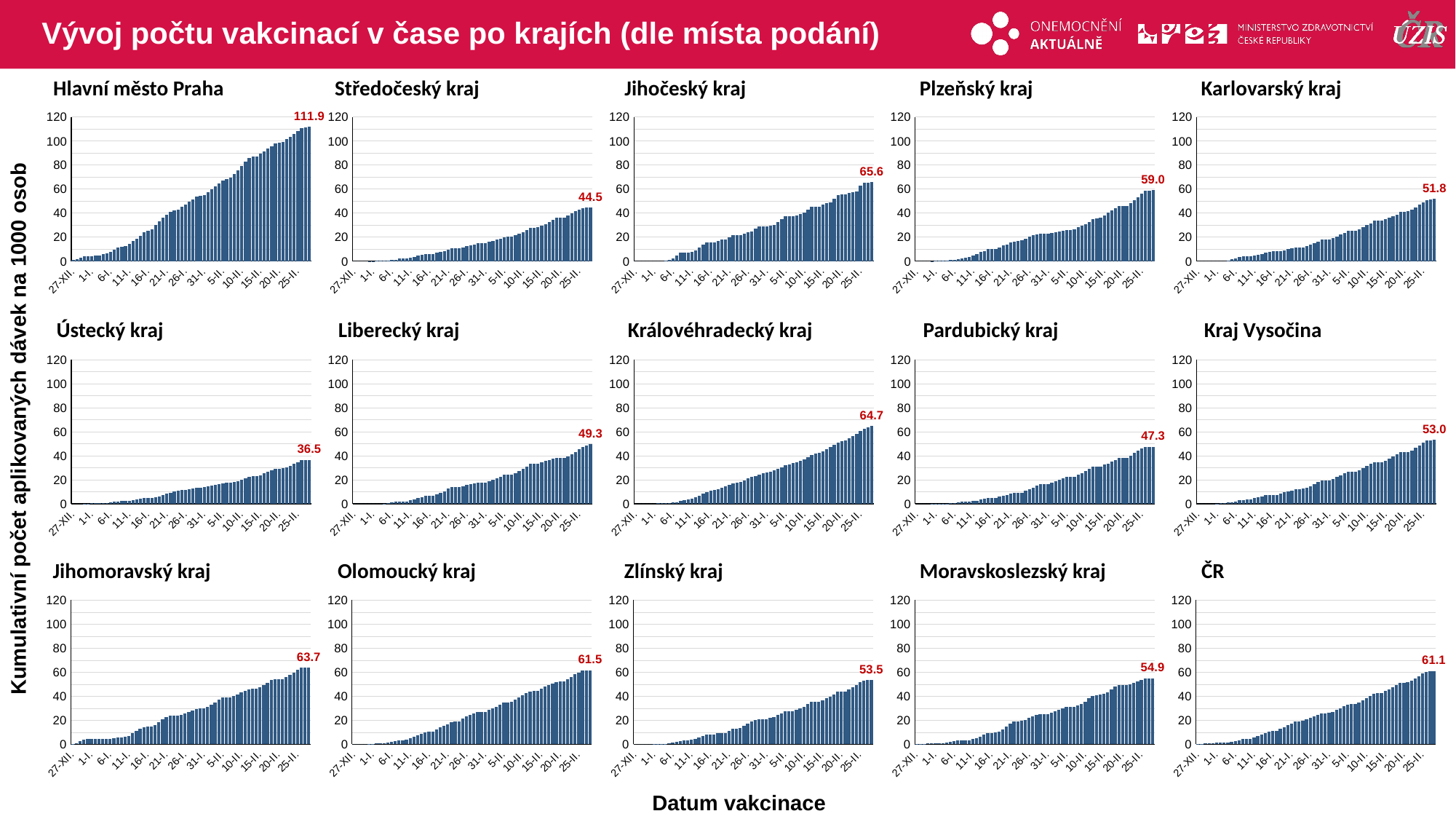
How many separate charts are shown on the slide? 15 In the ČR chart, what is the final labelled value? 61.1 Comparing the final labelled values across all the charts, which region has the lowest value? Ústecký kraj What kind of chart is used for each region on the slide? Bar chart In the Ústecký kraj chart, what is the final labelled value? 36.5 What is the difference between the final labelled value in the Jihočeský kraj chart (65.6) and the Středočeský kraj chart (44.5)? 21.1 In the Královéhradecký kraj chart, what is the final labelled value? 64.7 Comparing the final labelled values across all the charts, which region has the highest value? Hlavní město Praha Which final labelled value is larger: Olomoucký kraj or Zlínský kraj? Olomoucký kraj In the Moravskoslezský kraj chart, do the values rise or fall along the x axis? Rise In the Hlavní město Praha chart, what is the final labelled value? 111.9 In the Liberecký kraj chart, is the final value greater or less than 40? greater